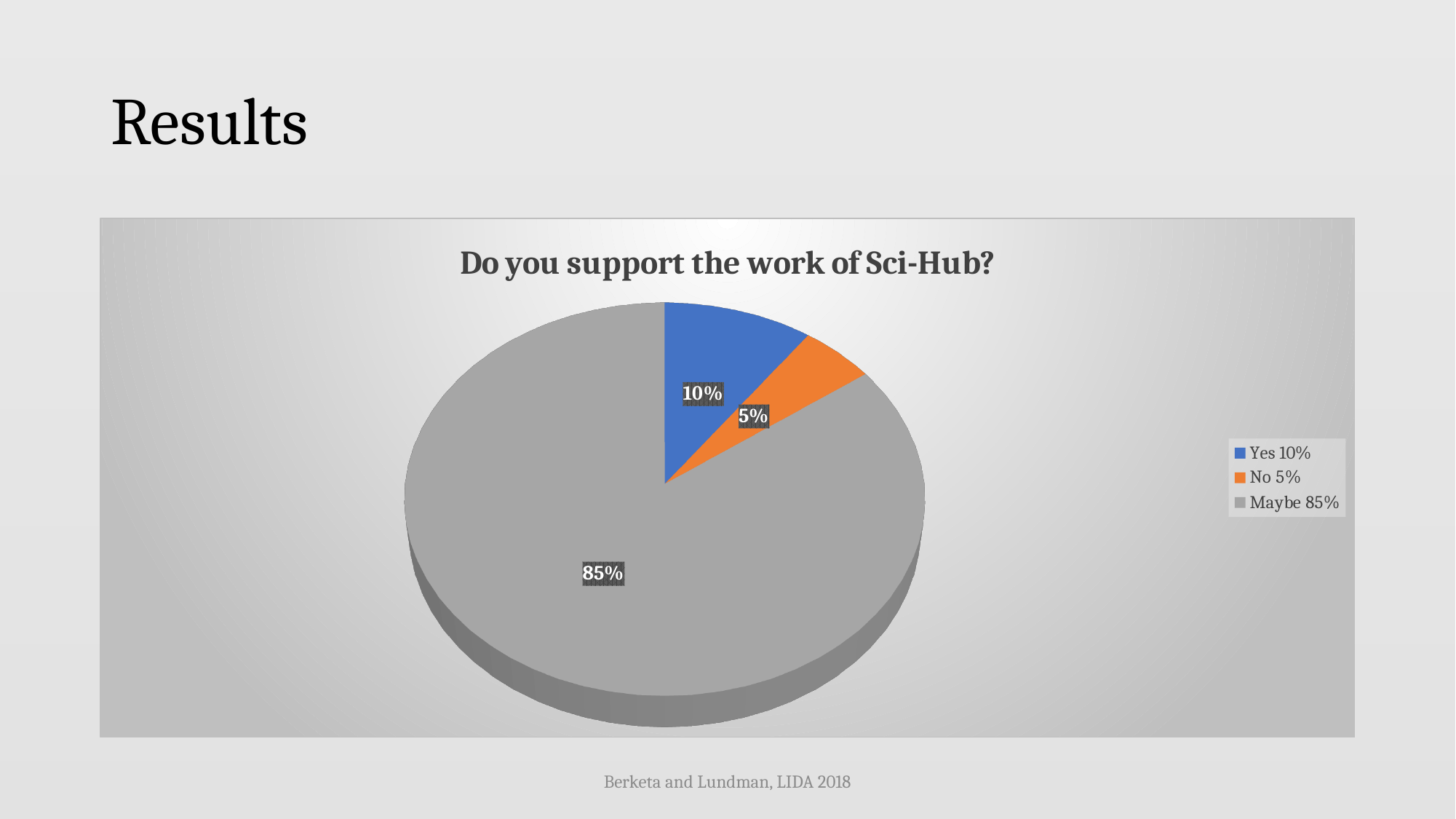
What colour is the "Maybe" slice? Grey How many entries does the legend list? 3 What percentage of respondents answered "Yes"? 10% What kind of chart is shown on the slide? Pie chart Which response has the largest share of the pie? Maybe What percentage of respondents answered "No"? 5% What is the difference in percentage points between the "Maybe" and "Yes" slices? 75 What percentage of respondents answered "Maybe"? 85% What is the title of the chart? Do you support the work of Sci-Hub? Which is larger, the "Yes" slice or the "No" slice? Yes How many slices does the pie chart have? 3 Which response has the smallest share of the pie? No